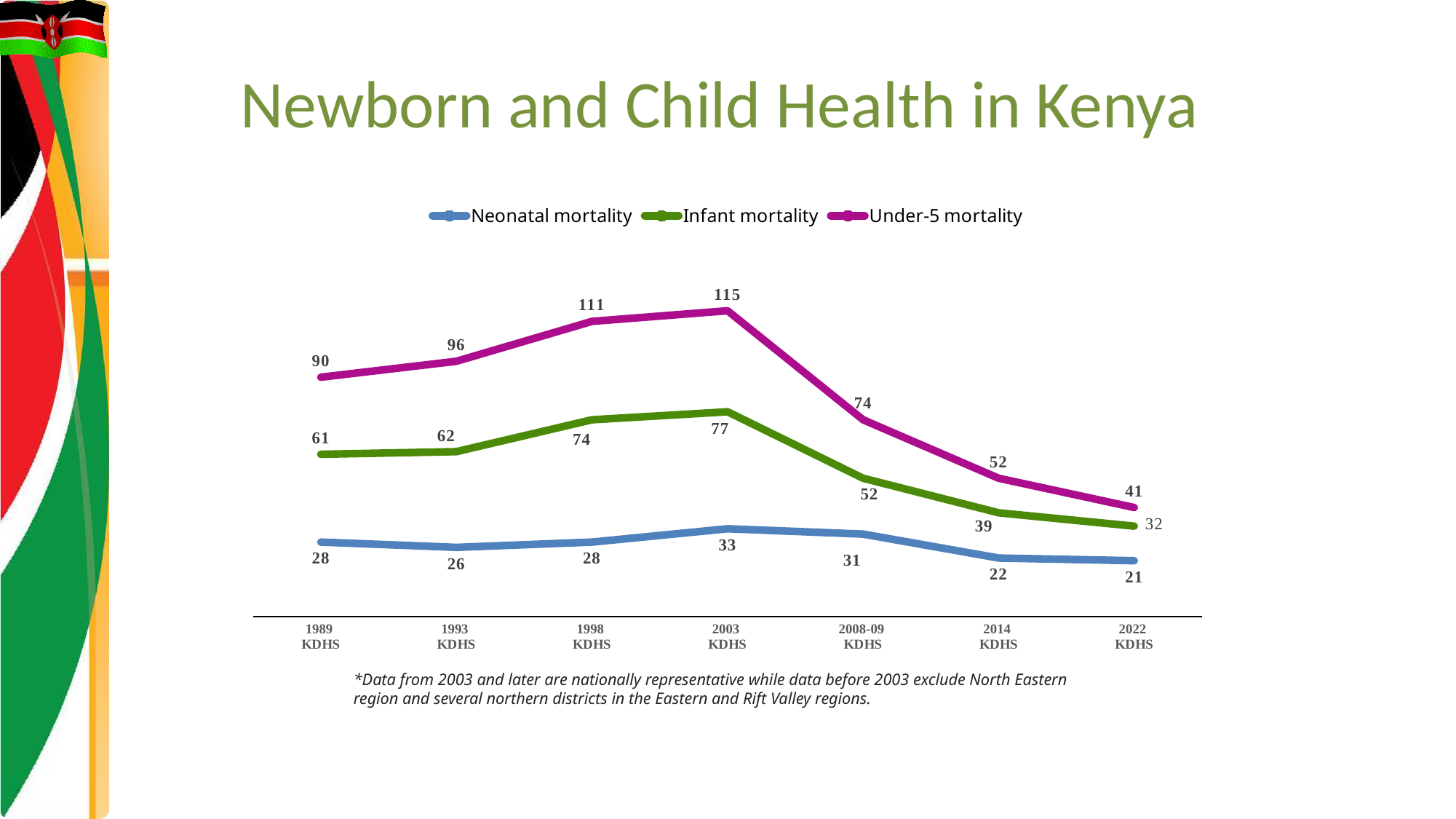
What is the Neonatal mortality value for 2022 KDHS? 21 In which survey year is Neonatal mortality lowest? 2022 KDHS Does Under-5 mortality rise or fall from 2003 KDHS to 2022 KDHS? Fall How many series does the legend list? 3 In which survey year is Under-5 mortality highest? 2003 KDHS Which is larger: Infant mortality in 2014 KDHS or Under-5 mortality in 2022 KDHS? Under-5 mortality in 2022 KDHS What is the difference between Under-5 mortality and Infant mortality in 2008-09 KDHS? 22 What is the Under-5 mortality value for 2003 KDHS? 115 What kind of chart is shown on the slide? Line chart By how much did Under-5 mortality fall from 2003 KDHS to 2022 KDHS? 74 How many survey points are shown on the x axis? 7 What is the Infant mortality value for 1998 KDHS? 74